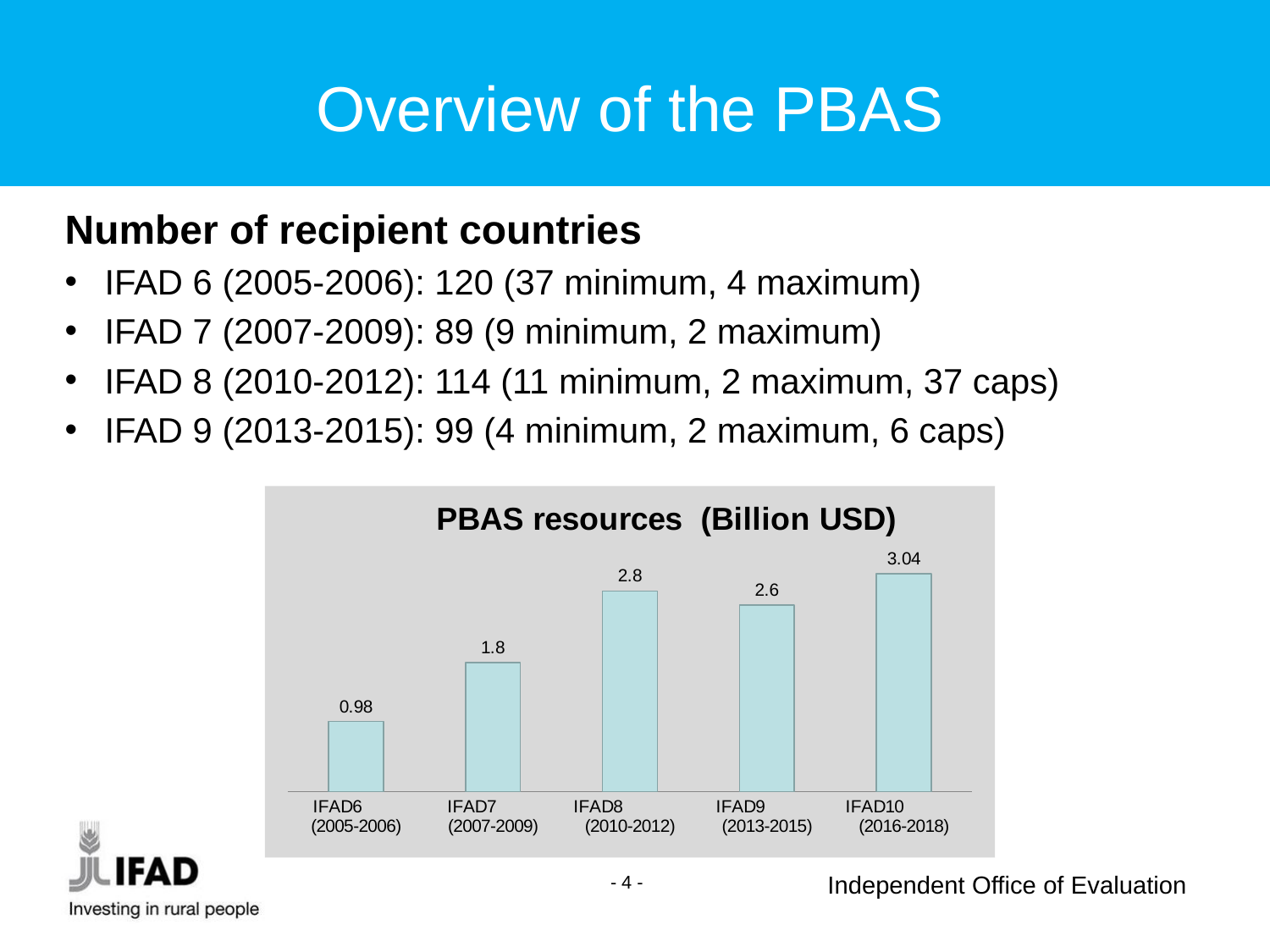
What kind of chart is used to show PBAS resources? Bar chart What is the difference in PBAS resources between IFAD7 and IFAD6? 0.82 What is the PBAS resources value for IFAD6 (2005-2006)? 0.98 How many replenishment periods are shown in the chart? 5 What is the PBAS resources value for IFAD10 (2016-2018)? 3.04 What is the PBAS resources value for IFAD8 (2010-2012)? 2.8 What is the difference in PBAS resources between IFAD8 and IFAD9? 0.2 Which replenishment period has the highest PBAS resources? IFAD10 (2016-2018) What is the title of the chart? PBAS resources (Billion USD) Do PBAS resources generally rise or fall from IFAD6 to IFAD10? Rise Which replenishment period has the lowest PBAS resources? IFAD6 (2005-2006) Which has larger PBAS resources, IFAD8 or IFAD9? IFAD8